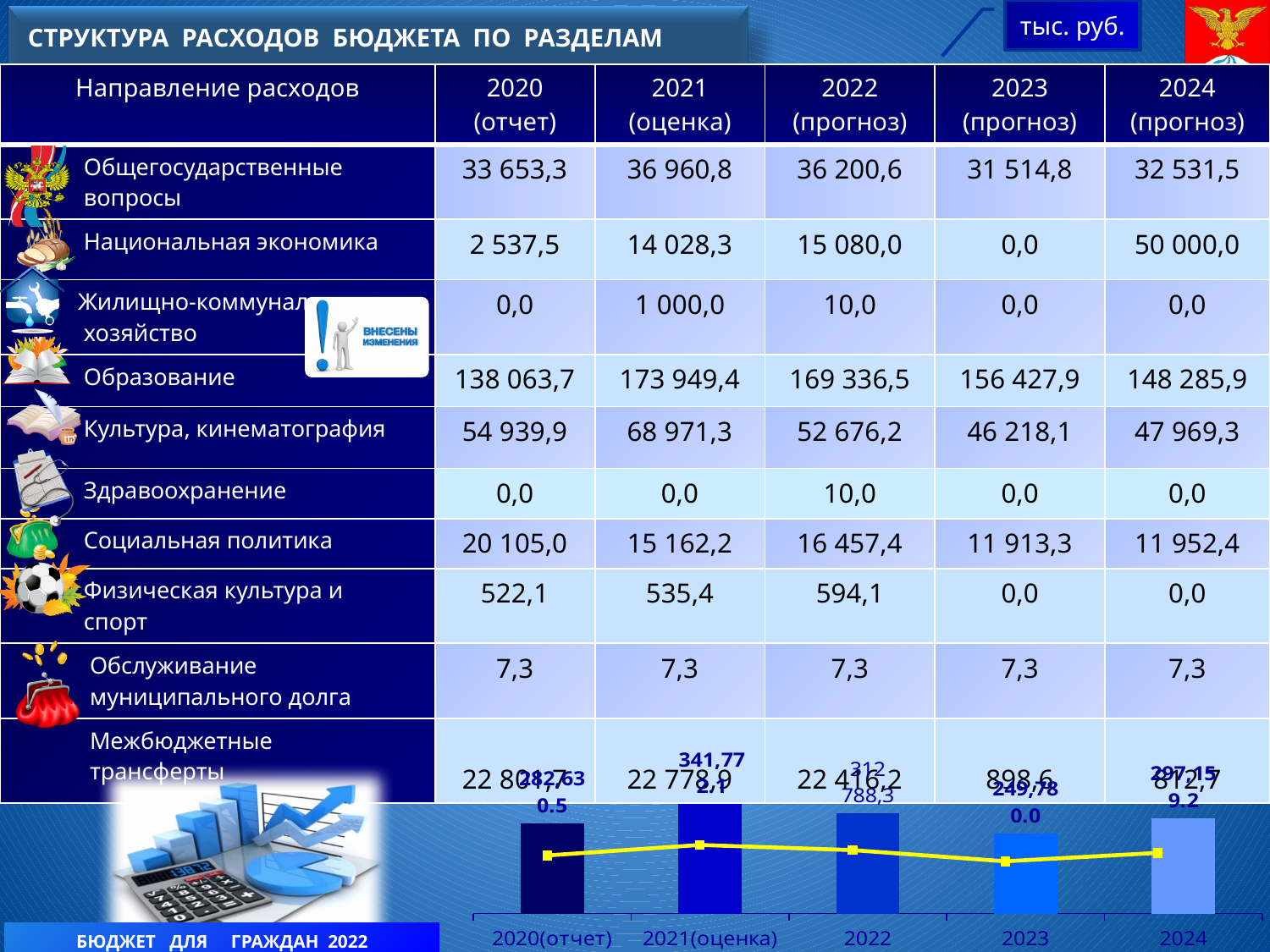
What colour is the line plotted in the chart at the bottom of the slide? Yellow How many categories (years) are plotted along the x axis of the chart at the bottom of the slide? 5 In the chart at the bottom of the slide, which year has the shortest bar? 2023 In the chart at the bottom of the slide, what is the data label shown above the 2023 bar? 249,780.0 What is the label of the first category on the x axis of the chart at the bottom of the slide? 2020(отчет) In the chart at the bottom of the slide, is the bar for 2021(оценка) taller or shorter than the bar for 2023? Taller In the chart at the bottom of the slide, which year has the tallest bar? 2021(оценка) In the chart at the bottom of the slide, does the bar height rise or fall from 2021(оценка) to 2023? Fall What kind of chart is shown at the bottom of the slide? A bar chart combined with a line In the chart at the bottom of the slide, at which year does the yellow line reach its highest point? 2021(оценка) In the chart at the bottom of the slide, what is the data label shown above the 2021(оценка) bar? 341,772,1 In the chart at the bottom of the slide, at which year does the yellow line reach its lowest point? 2023